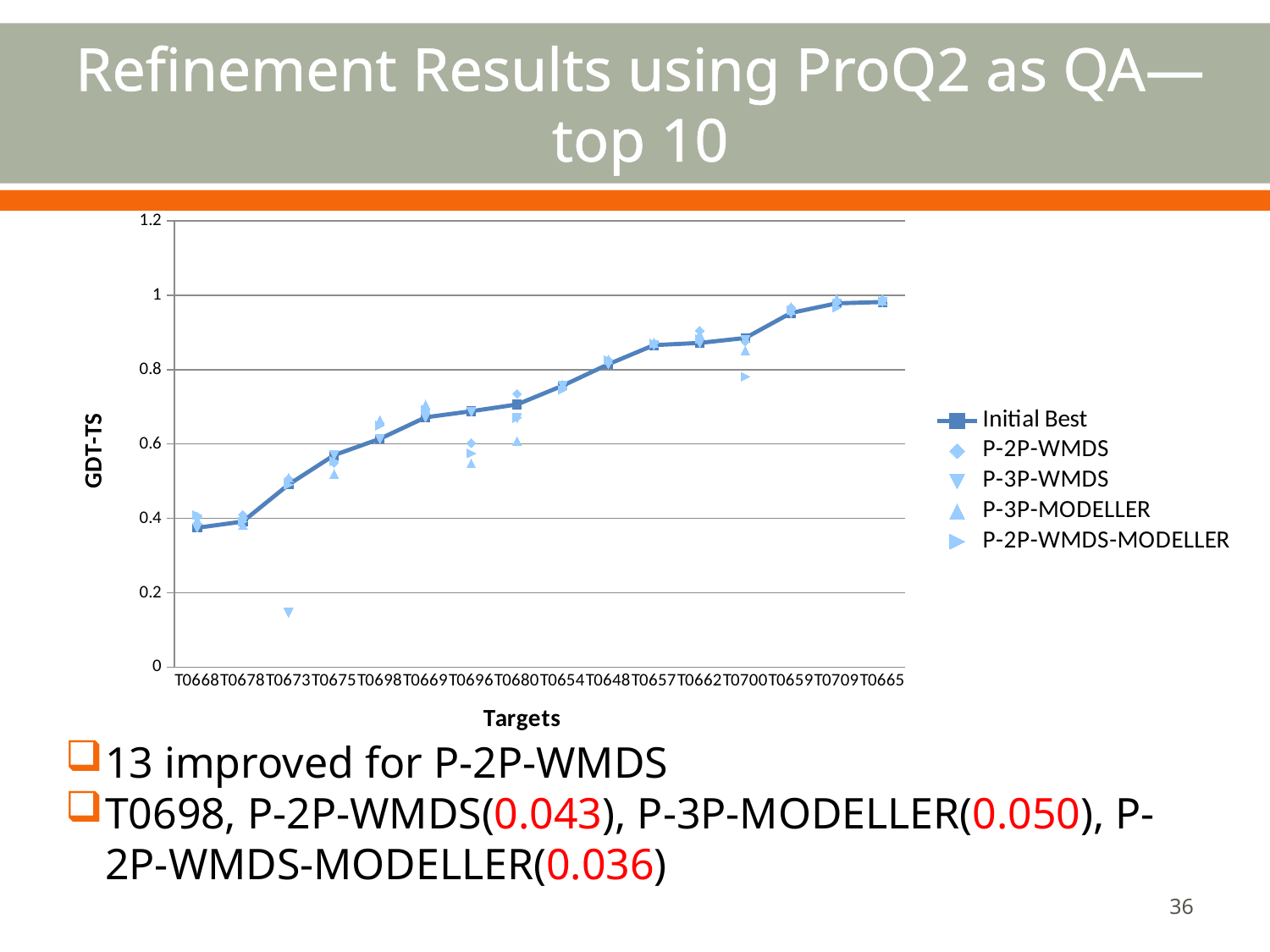
Does the Initial Best line generally rise or fall from left to right across the targets? rise How many targets are listed along the x axis of the chart? 16 Is the P-3P-WMDS point for T0673 greater or less than 0.2? less Is the Initial Best value for T0673 greater or less than 0.4? greater What is the title of the chart's vertical axis? GDT-TS How many series does the chart legend list? 5 What kind of chart is shown on the slide? line chart Which series has the lowest plotted point anywhere on the chart? P-3P-WMDS Is the Initial Best value for T0668 greater or less than 0.4? less Which has the larger Initial Best value, T0675 or T0648? T0648